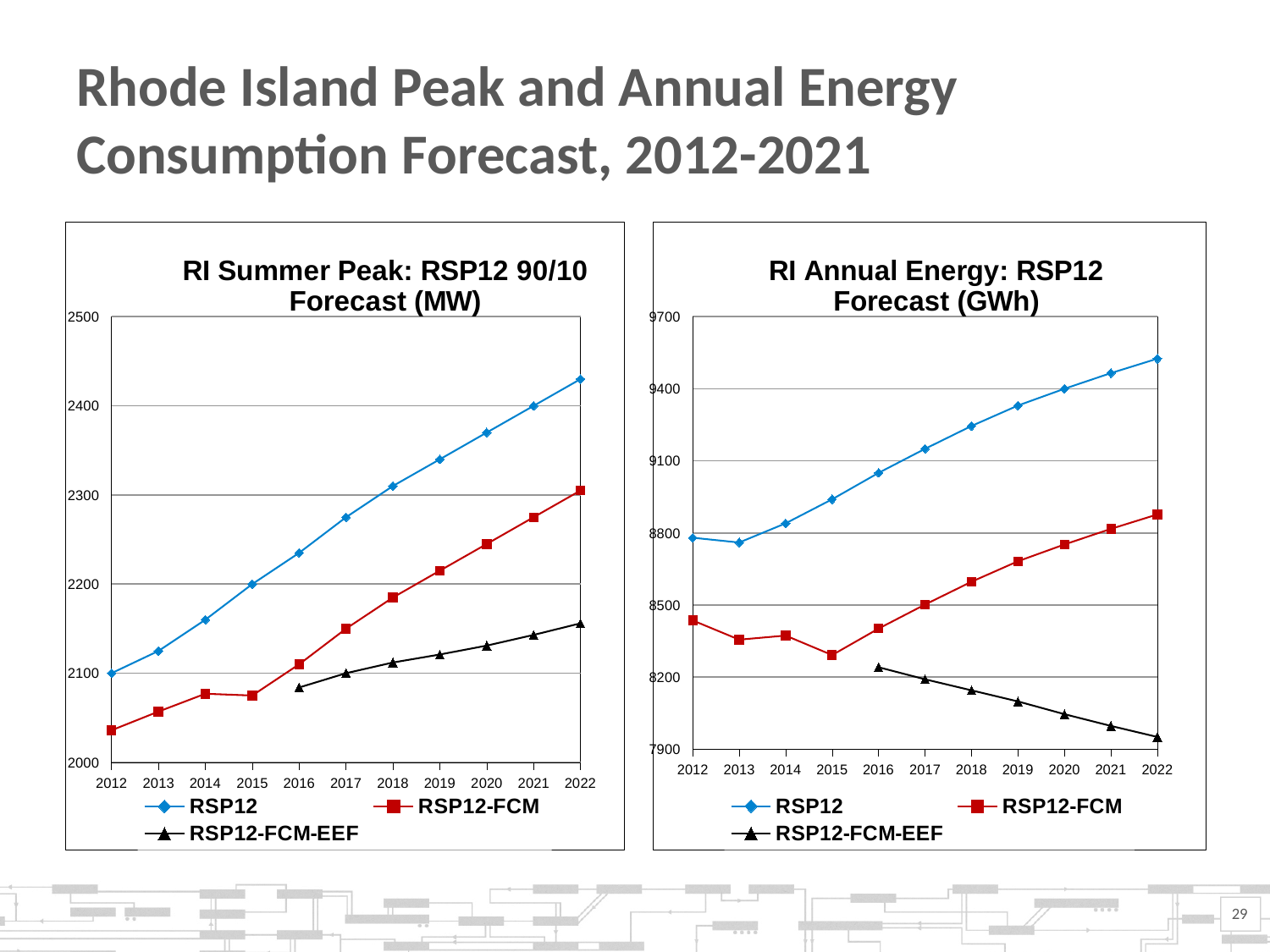
In the RI Annual Energy: RSP12 Forecast (GWh) chart, in which year is the RSP12 series highest? 2022 In the RI Annual Energy: RSP12 Forecast (GWh) chart, is the RSP12-FCM value for 2015 greater or less than 8500? less In the RI Summer Peak: RSP12 90/10 Forecast (MW) chart, is the RSP12-FCM value for 2012 greater or less than 2100? less In the RI Annual Energy: RSP12 Forecast (GWh) chart, in which year is the RSP12-FCM-EEF series lowest? 2022 In the RI Summer Peak: RSP12 90/10 Forecast (MW) chart, does the RSP12 series rise or fall from 2012 to 2022? rise In the RI Annual Energy: RSP12 Forecast (GWh) chart, does the RSP12-FCM-EEF series rise or fall from 2016 to 2022? fall In the RI Summer Peak: RSP12 90/10 Forecast (MW) chart, which series has the larger value in 2022, RSP12 or RSP12-FCM? RSP12 How many series does the legend of the RI Annual Energy: RSP12 Forecast (GWh) chart list? 3 How many years are shown on the x axis of the RI Summer Peak: RSP12 90/10 Forecast (MW) chart? 11 In the RI Summer Peak: RSP12 90/10 Forecast (MW) chart, is the RSP12 value for 2022 greater or less than 2400? greater What kind of chart is the RI Summer Peak: RSP12 90/10 Forecast (MW) chart? line chart What is the title of the chart on the left of the slide? RI Summer Peak: RSP12 90/10 Forecast (MW)